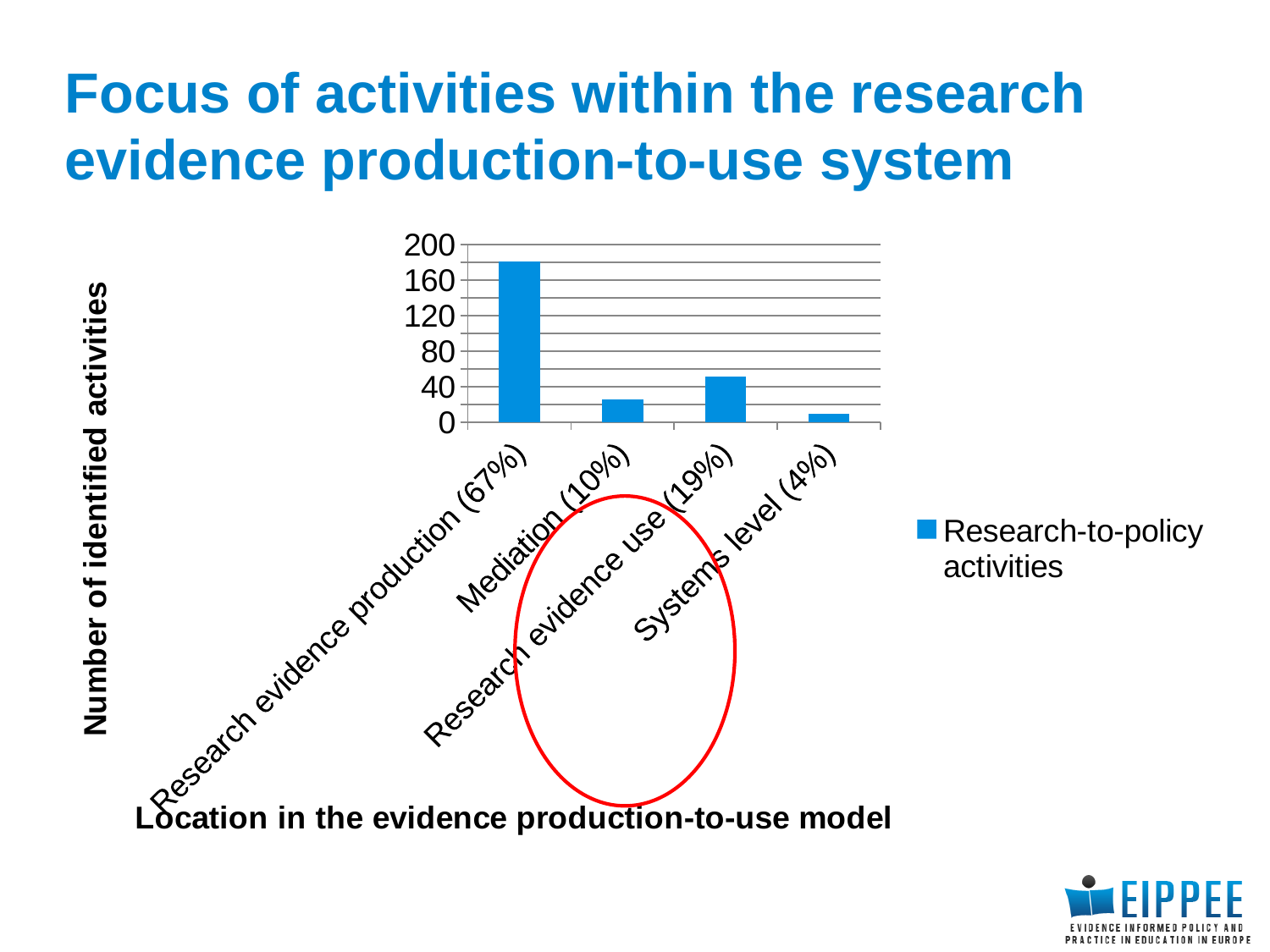
Which category has the highest number of identified activities? Research evidence production (67%) What is the series name shown in the chart's legend? Research-to-policy activities Which has more identified activities, Mediation (10%) or Systems level (4%)? Mediation (10%) Which category has the lowest number of identified activities? Systems level (4%) Which has more identified activities, Mediation (10%) or Research evidence use (19%)? Research evidence use (19%) What kind of chart is shown on the slide? bar chart Is the value for Research evidence use (19%) greater or less than 40? greater How many series does the chart's legend list? 1 Is the value for Mediation (10%) greater or less than 40? less How many categories are plotted on the x axis of the chart? 4 Is the value for Research evidence production (67%) greater or less than 160? greater